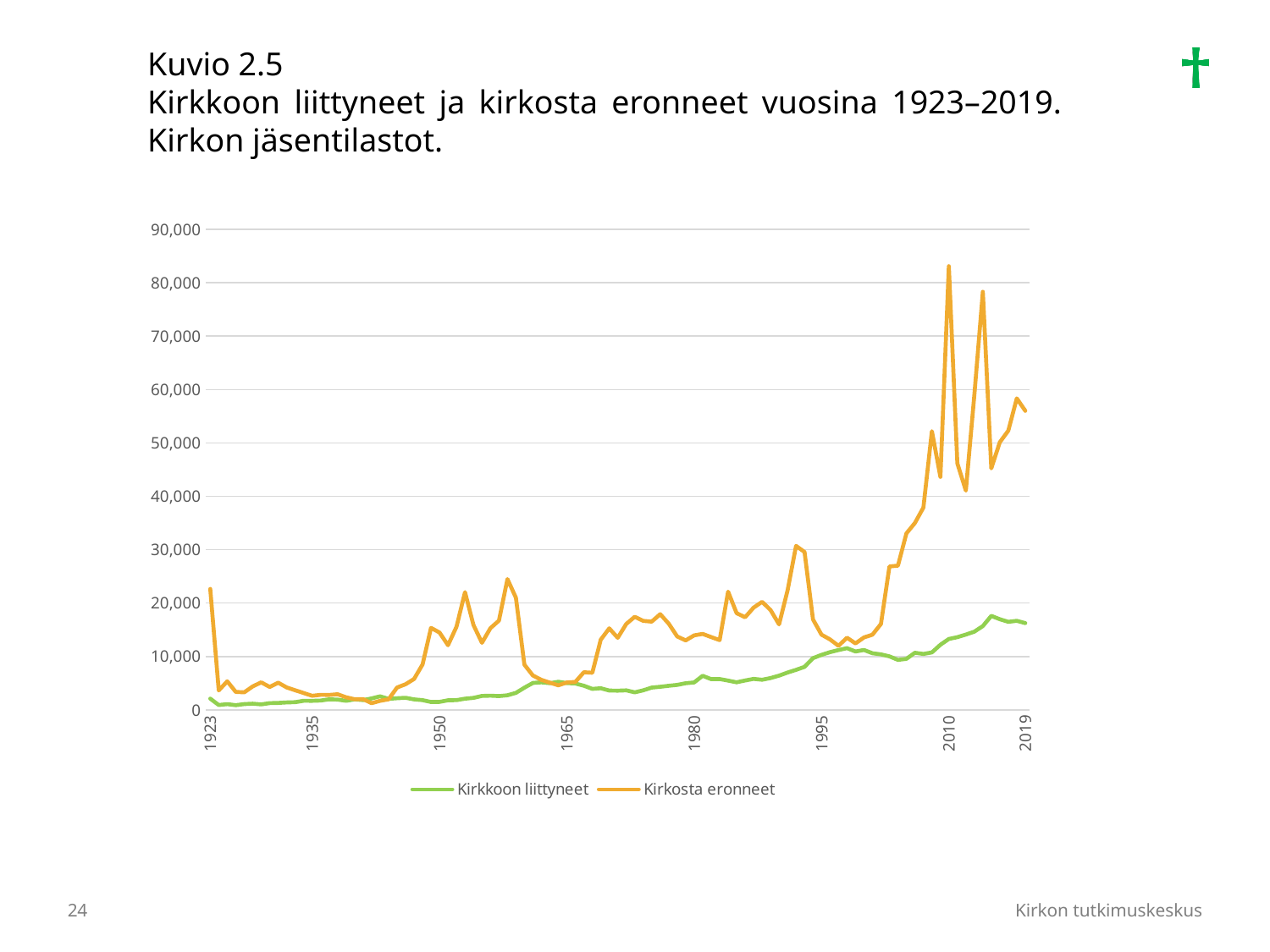
Is the value for Kirkosta eronneet in 2010 greater or less than 70,000? greater What is the highest value shown on the y axis? 90,000 Does the Kirkkoon liittyneet line generally rise or fall from 1923 to 2019? rise Which series reaches the highest value anywhere on the chart? Kirkosta eronneet Is the value for Kirkkoon liittyneet in 1950 greater or less than 10,000? less In 2010, which series has the larger value, Kirkkoon liittyneet or Kirkosta eronneet? Kirkosta eronneet What kind of chart is shown on the slide? line chart Is the value for Kirkkoon liittyneet in 2019 greater or less than 20,000? less How many series does the legend list? 2 What are the two series named in the legend? Kirkkoon liittyneet and Kirkosta eronneet What colour is the line for Kirkosta eronneet? orange